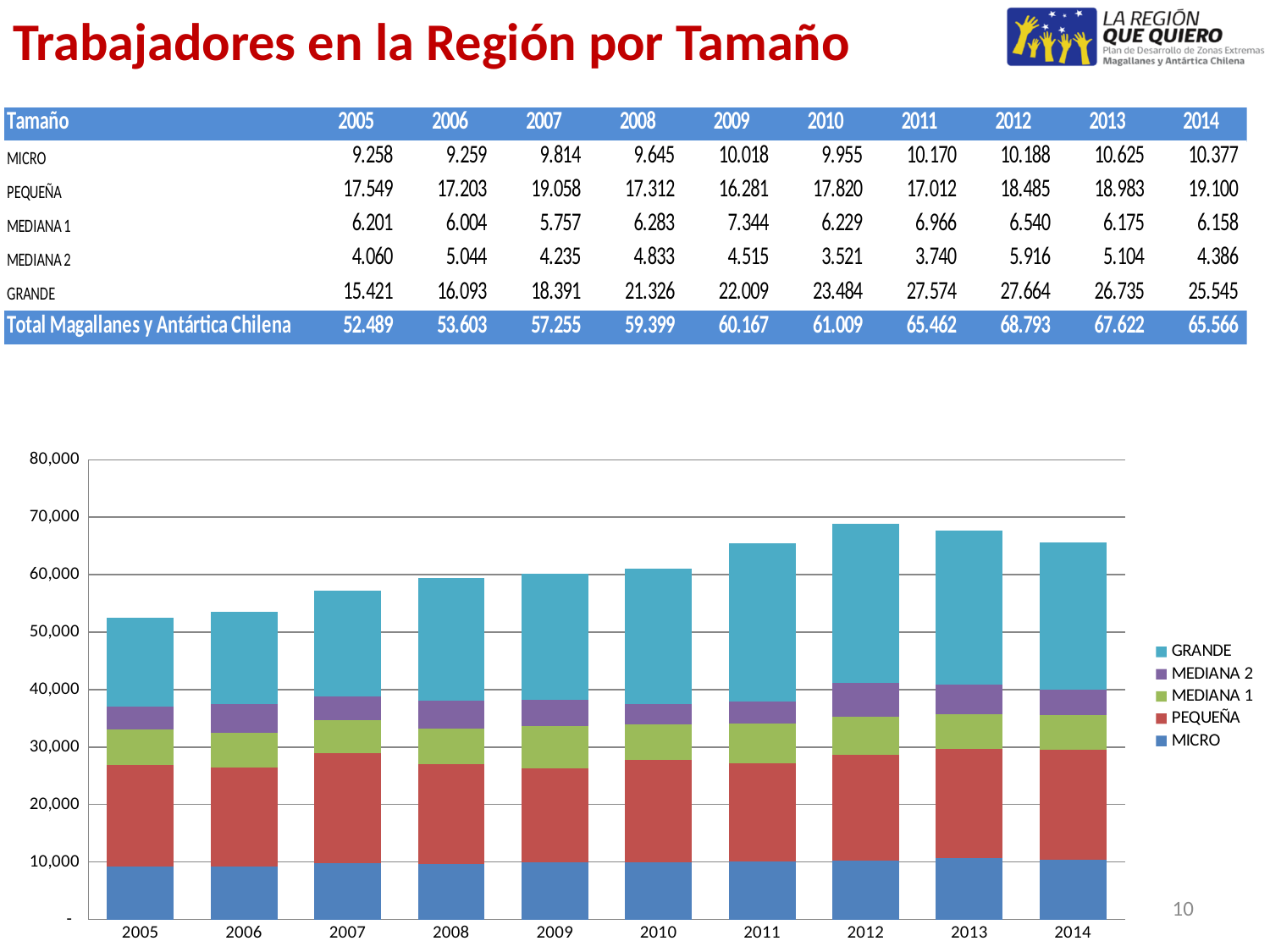
How many series does the chart legend list? 5 Do the total bar heights generally rise or fall from 2005 to 2012? rise Which series forms the bottom segment of each stacked bar? MICRO What is the value for GRANDE in 2011? 27.574 What is the difference between the GRANDE value in 2012 and in 2005? 12.243 What kind of chart is shown on the slide? bar chart Is the total bar for 2005 greater or less than 60,000? less How many years are shown along the x axis of the chart? 10 In 2005, which is larger: PEQUEÑA or GRANDE? PEQUEÑA Which year has the lowest total for Magallanes y Antártica Chilena? 2005 What is the total for Magallanes y Antártica Chilena in 2014? 65.566 Which year has the highest total for Magallanes y Antártica Chilena? 2012